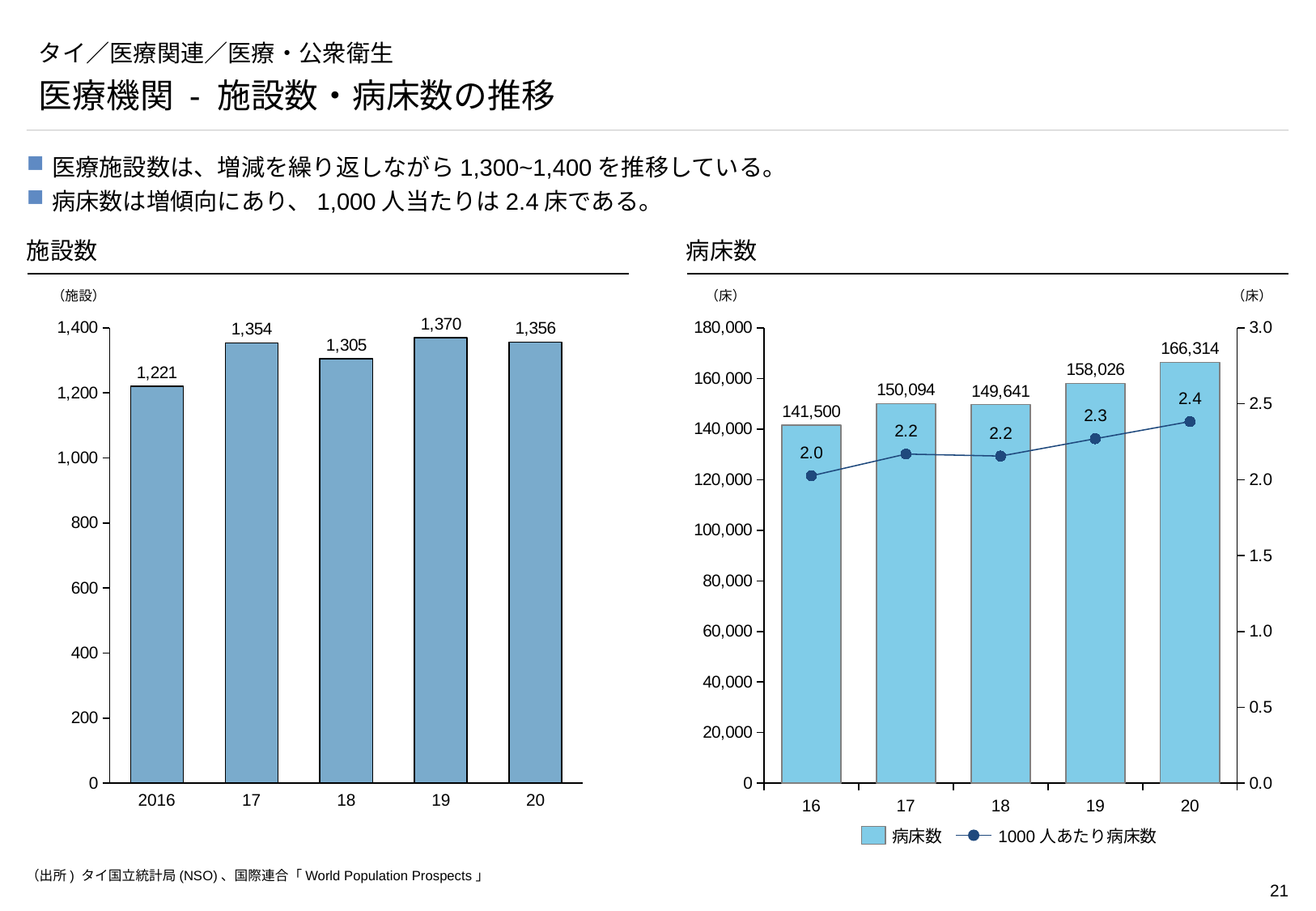
In the 病床数 chart on the right, is the 病床数 value for 17 larger than the value for 18? Yes In the 施設数 chart on the left, which year has the lowest value? 2016 In the 病床数 chart on the right, how many series does the legend list? 2 In the 施設数 chart on the left, which year has the highest value? 19 In the 施設数 chart on the left, what is the difference between the values for 19 and 18? 65 In the 病床数 chart on the right, what is the 1000人あたり病床数 value for 16? 2.0 In the 病床数 chart on the right, what is the difference between the 病床数 values for 20 and 19? 8,288 In the 施設数 chart on the left, what is the value for 2016? 1,221 What kind of chart is the 施設数 chart on the left? bar chart In the 病床数 chart on the right, which year has the lowest 病床数 value? 16 In the 施設数 chart on the left, how many bars are plotted? 5 In the 病床数 chart on the right, what is the 病床数 value for 20? 166,314